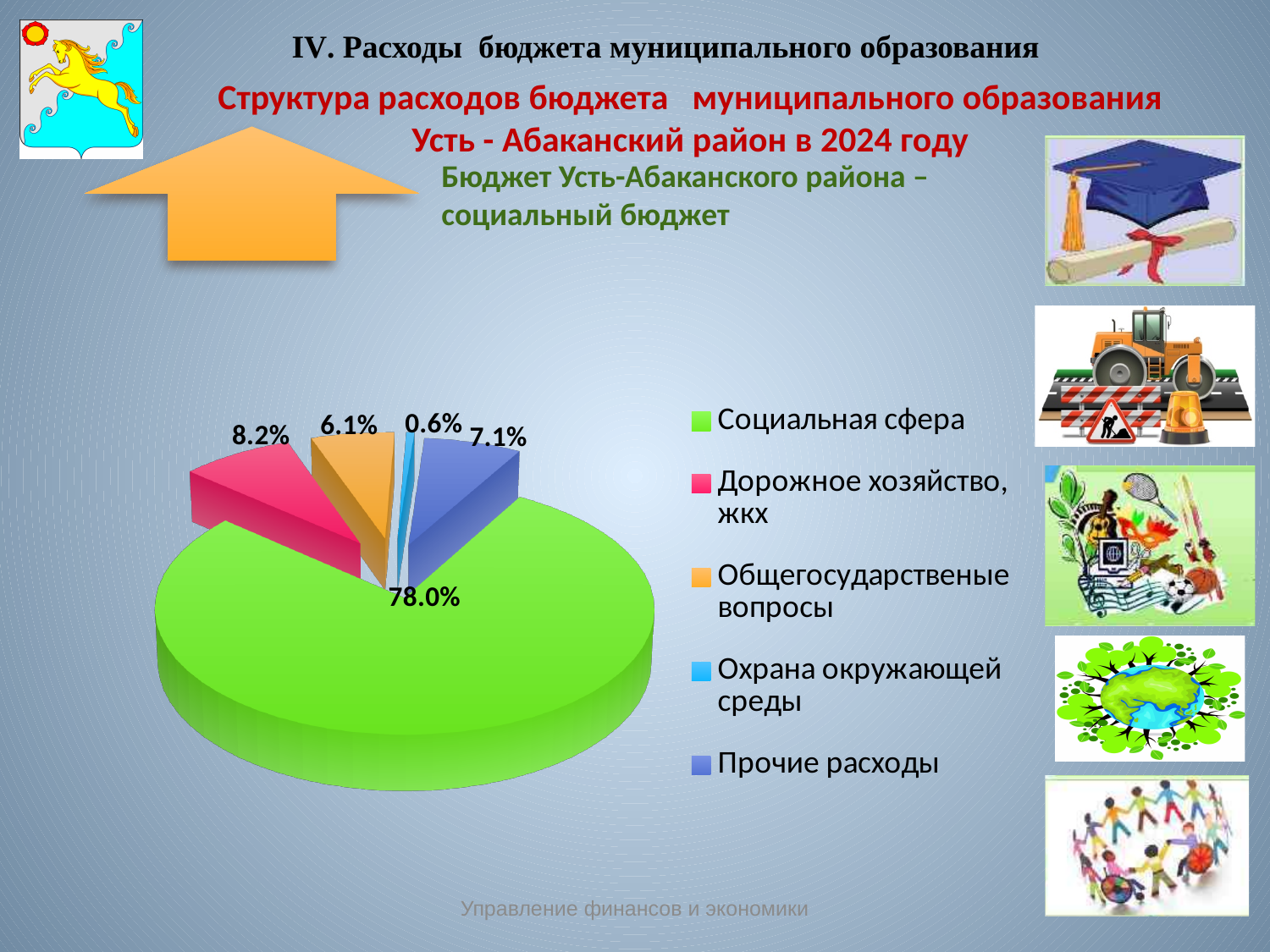
What is the difference in percentage points between Дорожное хозяйство, жкх and Прочие расходы? 1.1 Which is larger: the share for Прочие расходы or the share for Общегосударственые вопросы? Прочие расходы Which category has the smallest share of the pie chart? Охрана окружающей среды What share of the pie chart is labelled for Социальная сфера? 78.0% Which category has the largest share of the pie chart? Социальная сфера What percentage is shown for Охрана окружающей среды? 0.6% What percentage is shown for Прочие расходы? 7.1% What colour is the slice for Социальная сфера? Green What percentage is shown for Общегосударственые вопросы? 6.1% How many categories does the pie chart show? 5 What type of chart is shown on the slide? Pie chart What percentage is shown for Дорожное хозяйство, жкх? 8.2%